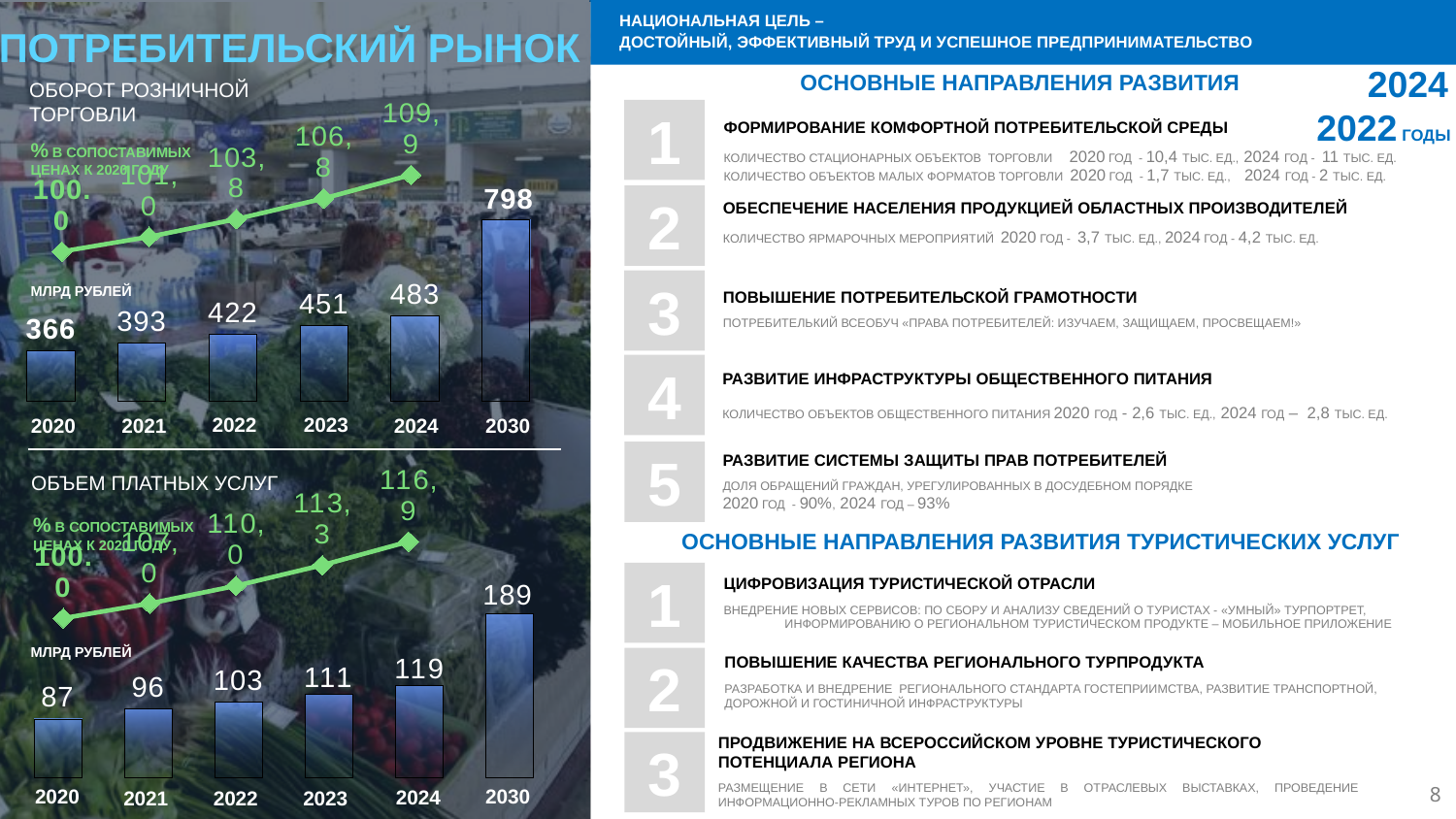
On the ОБЪЕМ ПЛАТНЫХ УСЛУГ chart, what percentage value does the line show for 2023? 113,3 On the ОБОРОТ РОЗНИЧНОЙ ТОРГОВЛИ chart, what is the value (млрд рублей) shown for 2030? 798 On the ОБОРОТ РОЗНИЧНОЙ ТОРГОВЛИ chart, do the bar values rise or fall from 2020 to 2030? rise On the ОБОРОТ РОЗНИЧНОЙ ТОРГОВЛИ chart, which year has the highest bar? 2030 On the ОБЪЕМ ПЛАТНЫХ УСЛУГ chart, which year has the larger bar value, 2021 or 2022? 2022 On the ОБЪЕМ ПЛАТНЫХ УСЛУГ chart, what is the difference between the bar values for 2030 and 2020? 102 On the ОБЪЕМ ПЛАТНЫХ УСЛУГ chart, what is the bar value (млрд рублей) for 2024? 119 What kind of chart is the ОБЪЕМ ПЛАТНЫХ УСЛУГ chart? bar chart with a line On the ОБОРОТ РОЗНИЧНОЙ ТОРГОВЛИ chart, what percentage value does the line show for 2024? 109,9 On the ОБОРОТ РОЗНИЧНОЙ ТОРГОВЛИ chart, how many years are shown on the x axis? 6 On the ОБОРОТ РОЗНИЧНОЙ ТОРГОВЛИ chart, what is the difference between the bar values for 2030 and 2024? 315 On the ОБОРОТ РОЗНИЧНОЙ ТОРГОВЛИ chart, which year has the lowest bar? 2020